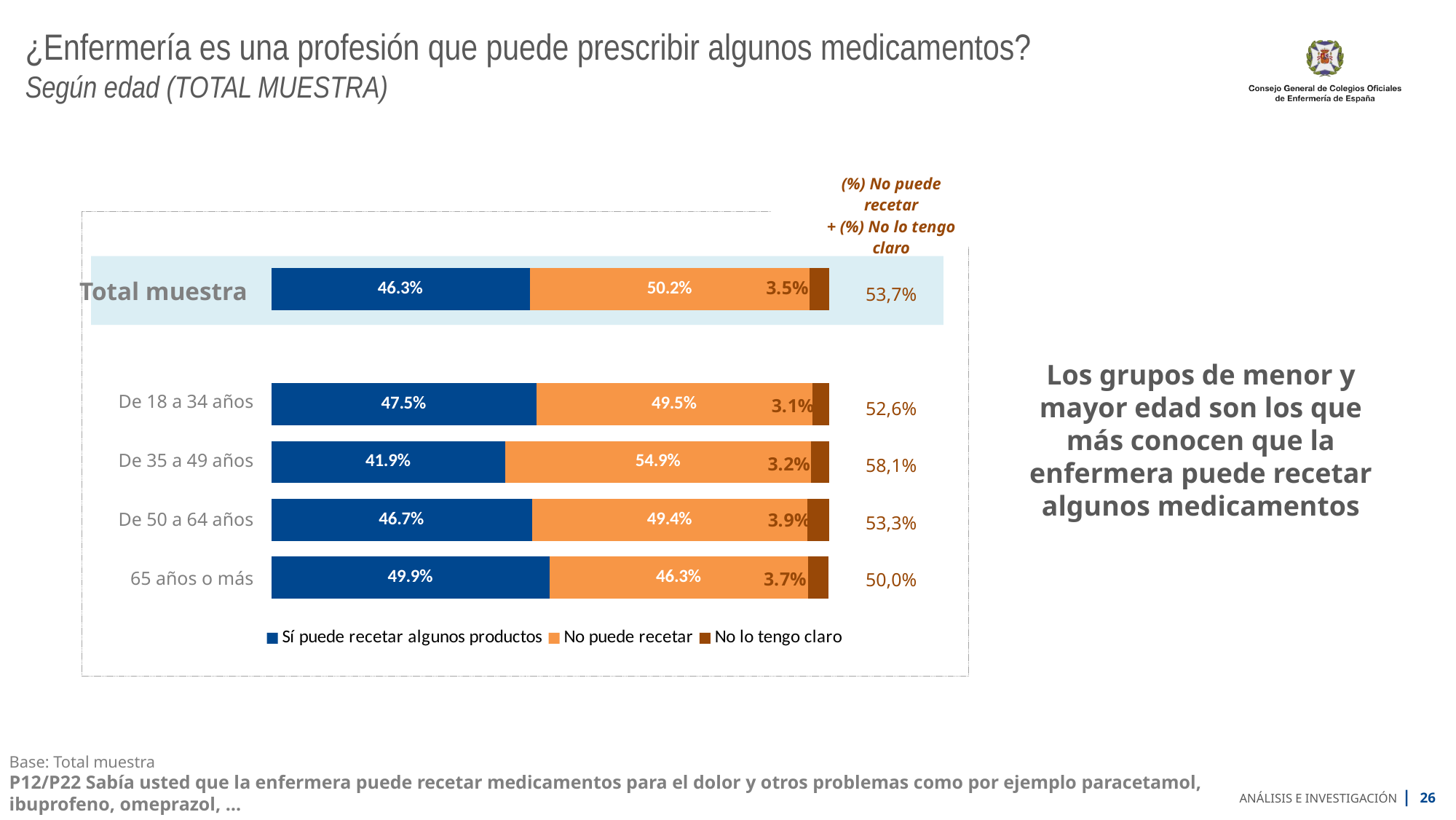
What type of chart is shown on the slide? Stacked bar chart How many series does the legend list? 3 What percentage of the 'De 18 a 34 años' group answered 'Sí puede recetar algunos productos'? 47.5% Which age group has the highest percentage for 'No lo tengo claro'? De 50 a 64 años Which is larger: the 'Sí puede recetar algunos productos' percentage for 'De 18 a 34 años' or for 'De 50 a 64 años'? De 18 a 34 años What percentage of the 'Total muestra' answered 'No lo tengo claro'? 3.5% Which age group has the highest percentage for 'Sí puede recetar algunos productos'? 65 años o más What is the combined '(%) No puede recetar + (%) No lo tengo claro' value shown for 'De 50 a 64 años'? 53,3% How many age groups (excluding 'Total muestra') are shown in the chart? 4 What percentage of the 'De 35 a 49 años' group answered 'No puede recetar'? 54.9% What is the difference between the 'No puede recetar' percentages for 'De 35 a 49 años' and '65 años o más'? 8.6 percentage points Which age group has the lowest percentage for 'Sí puede recetar algunos productos'? De 35 a 49 años